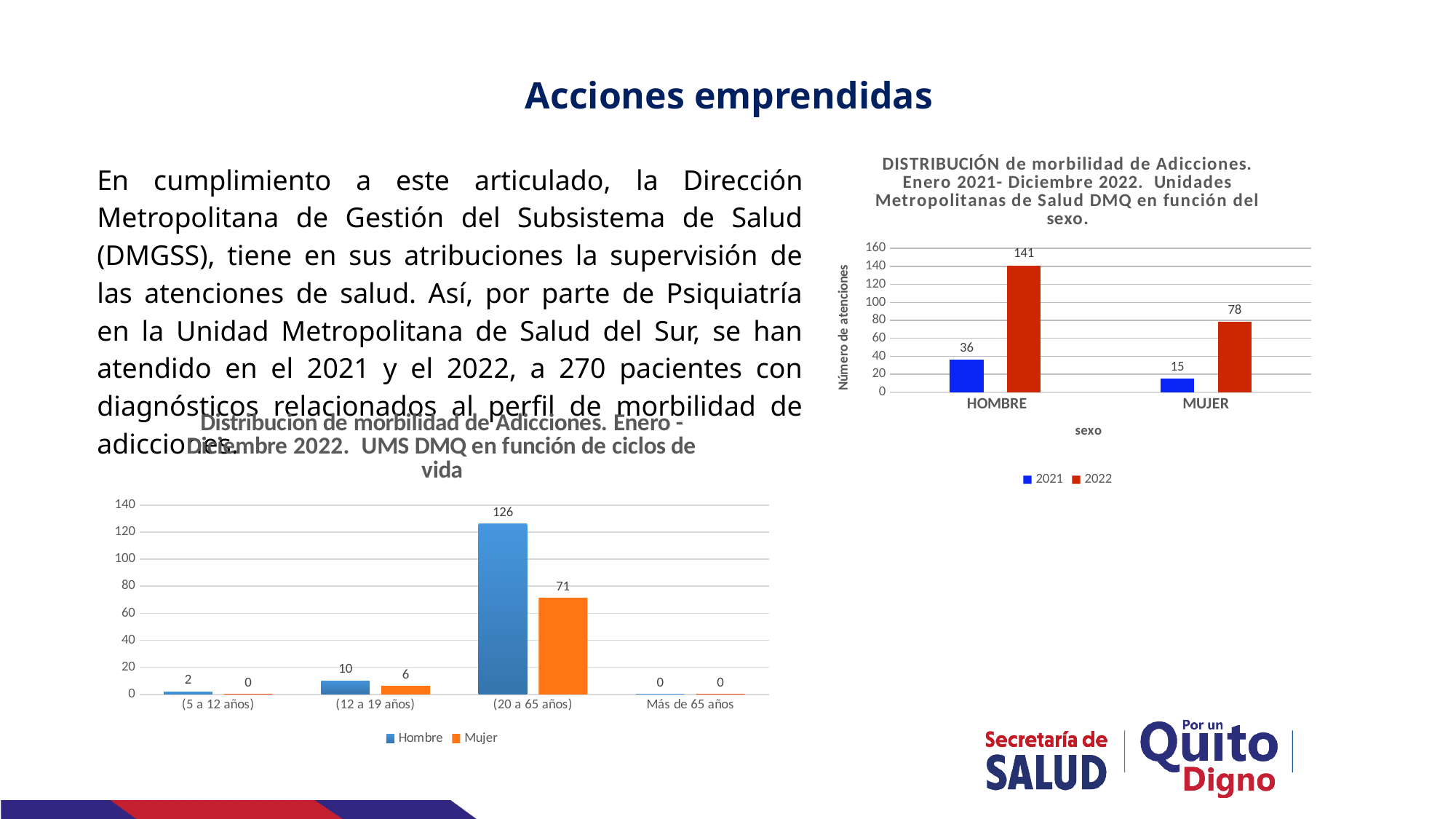
In the bottom-left chart (distribution by life cycle), how many age-group categories are shown on the x axis? 4 In the chart on the right (distribution by sex), what is the difference between the 2022 values for HOMBRE and MUJER? 63 In the bottom-left chart (distribution by life cycle), what is the Hombre value for (20 a 65 años)? 126 In the chart on the right (distribution by sex), what is the value for MUJER in 2021? 15 In the chart on the right (distribution by sex), what is the value for HOMBRE in 2022? 141 In the bottom-left chart (distribution by life cycle), what is the difference between the Hombre and Mujer values for (20 a 65 años)? 55 In the chart on the right (distribution by sex), how many series does the legend list? 2 In the bottom-left chart (distribution by life cycle), which age group has the highest Mujer value? (20 a 65 años) In the bottom-left chart (distribution by life cycle), what is the Mujer value for (12 a 19 años)? 6 What type of chart is the bottom-left chart (distribution by life cycle)? Bar chart In the chart on the right (distribution by sex), which series is shown in red? 2022 In the chart on the right (distribution by sex), is the 2021 value for HOMBRE greater or less than the 2021 value for MUJER? greater